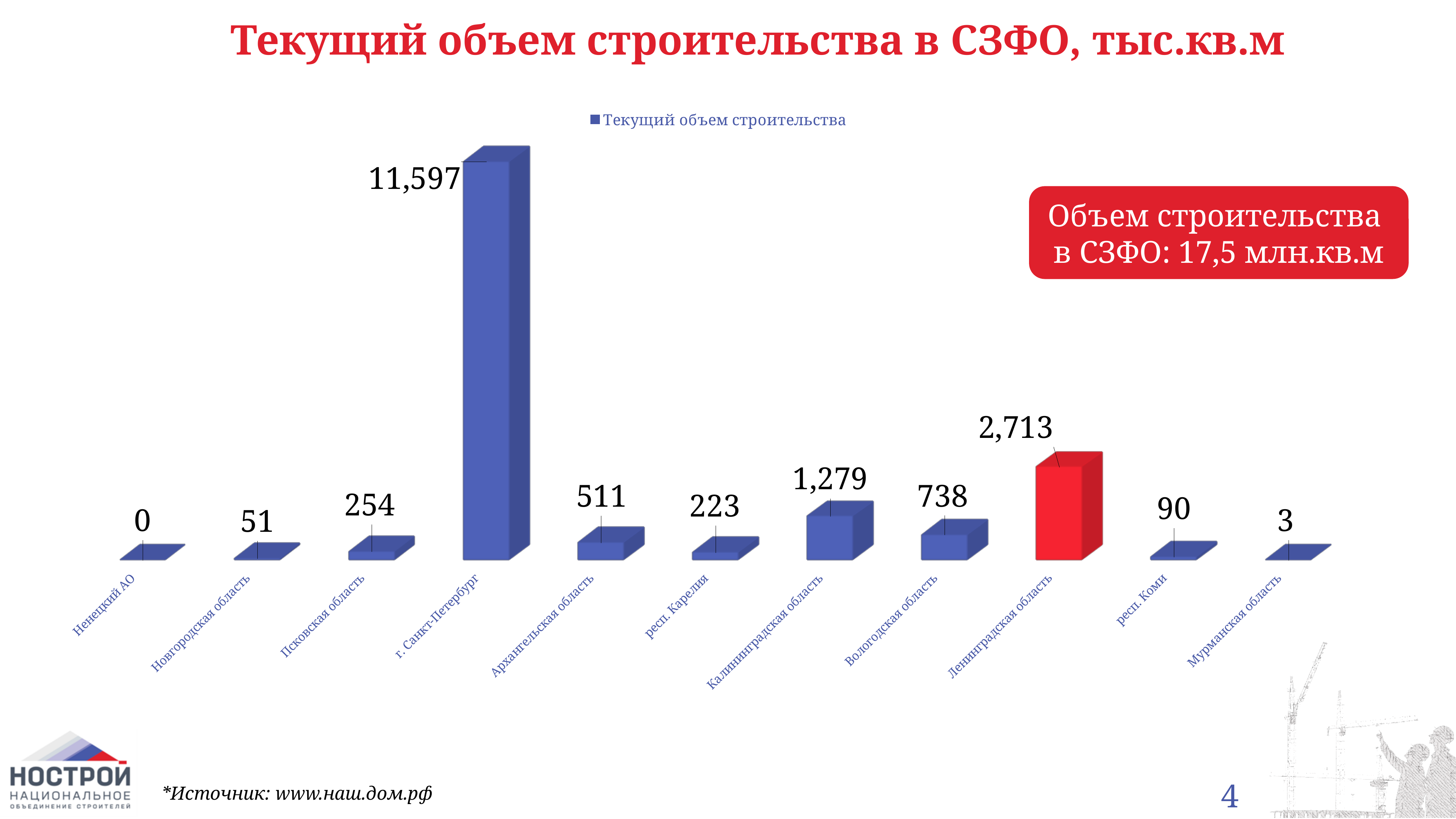
What is the value shown for Калининградская область? 1,279 What is the value shown for Мурманская область? 3 Which bar is coloured red instead of blue? Ленинградская область What kind of chart is shown on the slide? Bar chart How many series does the legend list? 1 Which region has the lowest current construction volume? Ненецкий АО Which is larger, the value for Вологодская область or the value for Архангельская область? Вологодская область What is the difference between the values for Ленинградская область and Калининградская область? 1,434 Which region has the highest current construction volume? г. Санкт-Петербург What is the current construction volume for г. Санкт-Петербург? 11,597 What is the value shown for Ленинградская область? 2,713 How many regions are shown on the x axis of the chart? 11